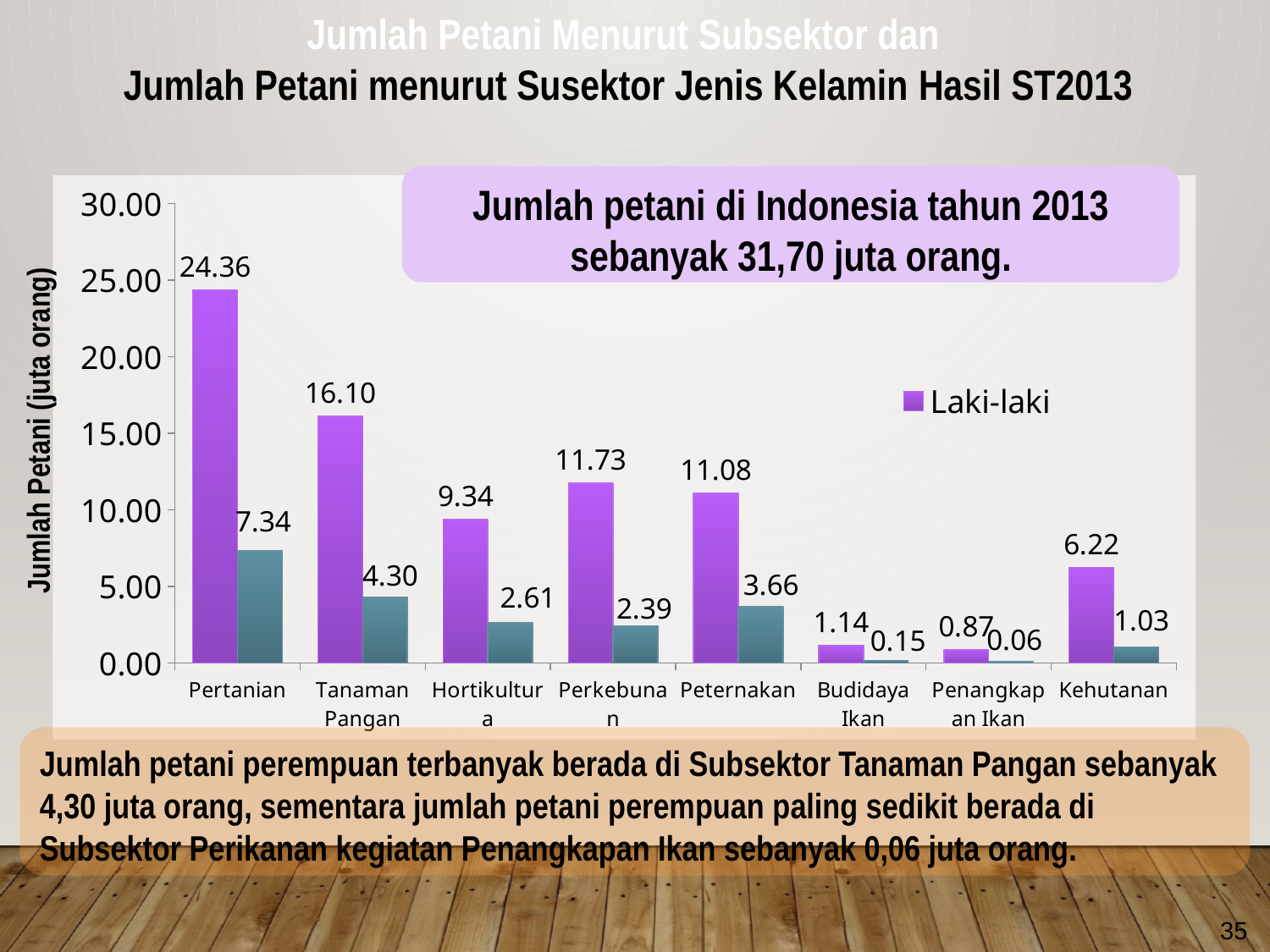
Which subsector has the highest Laki-laki value? Pertanian What is the value of the teal bar for Tanaman Pangan? 4.30 How many subsectors are shown on the x axis? 8 What is the difference between the purple bar and the teal bar for Pertanian? 17.02 Is the Laki-laki value for Tanaman Pangan greater or less than 15.00? greater What is the Laki-laki value for Kehutanan? 6.22 What kind of chart is shown on the slide? bar chart Which has a larger Laki-laki value, Hortikultura or Perkebunan? Perkebunan What is the title of the y axis? Jumlah Petani (juta orang) What is the Laki-laki value for Pertanian? 24.36 Which subsector has the lowest Laki-laki value? Penangkapan Ikan What is the difference between the Laki-laki values for Perkebunan and Peternakan? 0.65